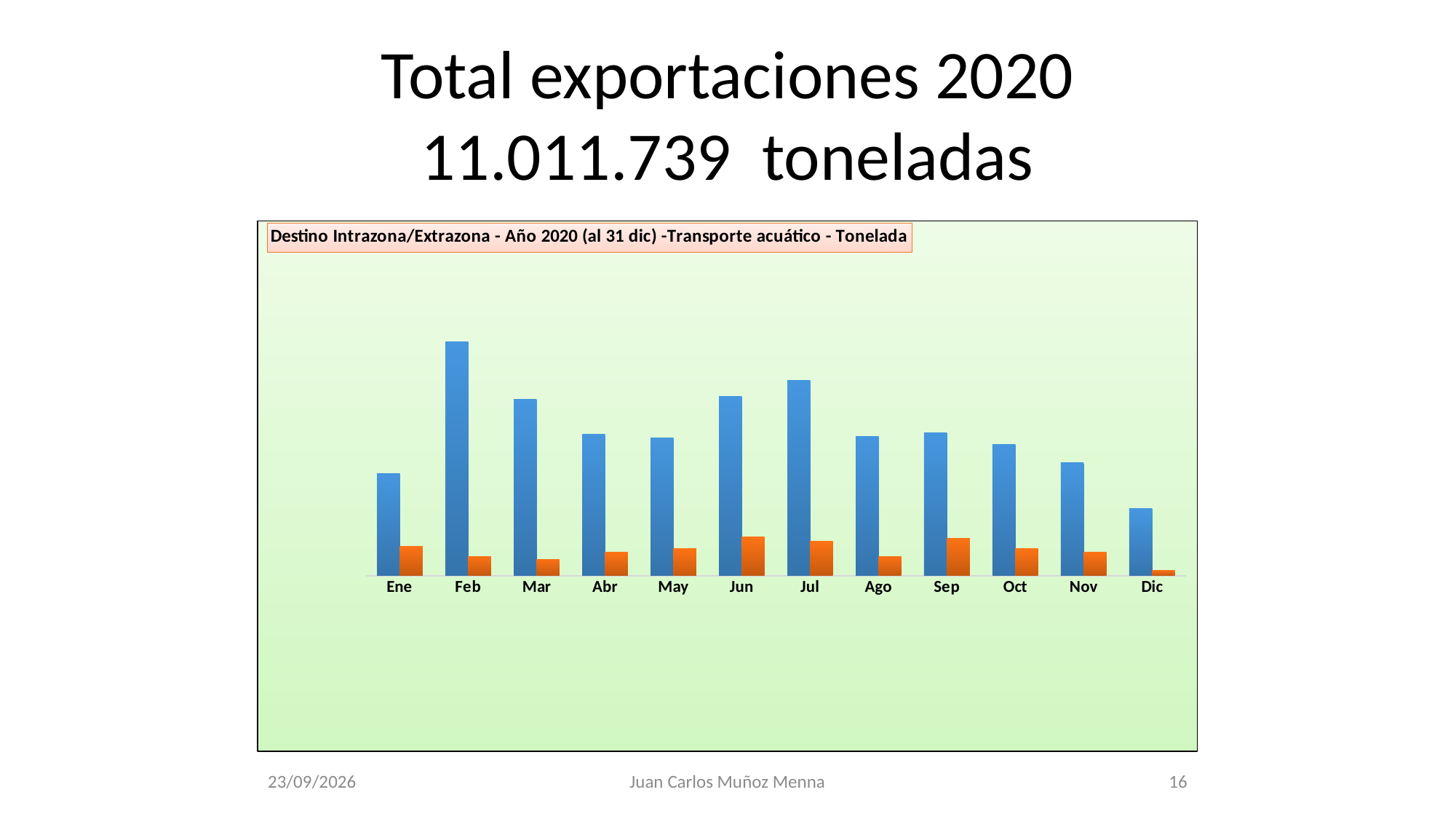
Which month has the shortest blue bar? Dic Is the blue bar for Feb taller or shorter than the blue bar for Mar? taller In Nov, which bar is taller, the blue one or the orange one? blue Which month has the shortest orange bar? Dic How many months are shown on the x axis of the chart? 12 Which month has the tallest blue bar? Feb Is the blue bar for Nov taller or shorter than the blue bar for Dic? taller How many bars are plotted for each month in the chart? 2 What kind of chart is shown on the slide? bar chart What is the title shown inside the chart area? Destino Intrazona/Extrazona - Año 2020 (al 31 dic) -Transporte acuático - Tonelada